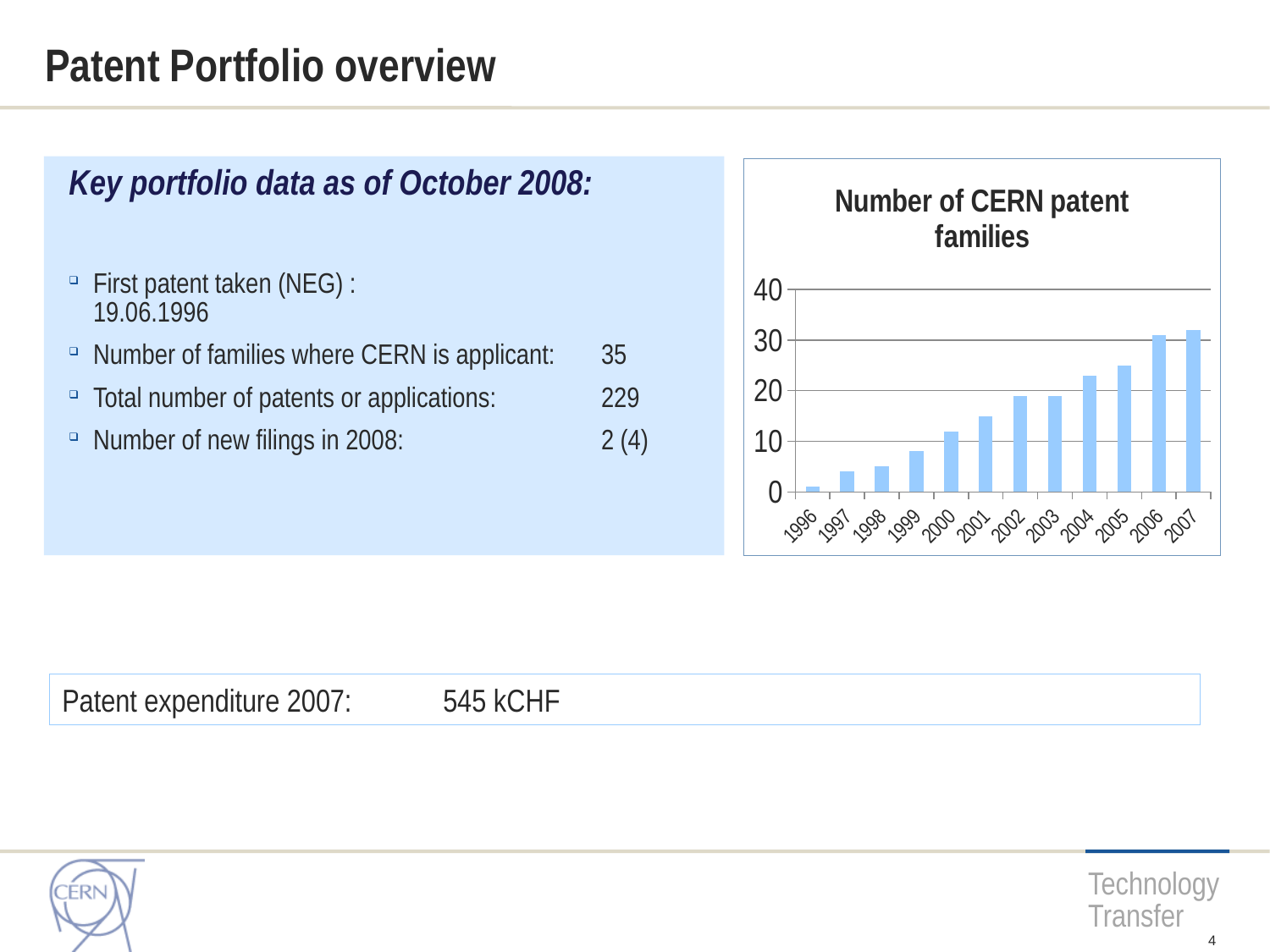
Is the value for 2004 greater or less than 20? greater What is the title of the chart? Number of CERN patent families Which year has the larger value, 1998 or 2000? 2000 Is the value for 2001 greater or less than 20? less How many years are shown on the x axis of the chart? 12 What kind of chart is shown on the slide? bar chart Do the values in the chart generally rise or fall from 1996 to 2007? rise Which year has the larger value, 2001 or 2004? 2004 Which year has the lowest number of CERN patent families? 1996 Is the value for 2007 greater or less than 30? greater